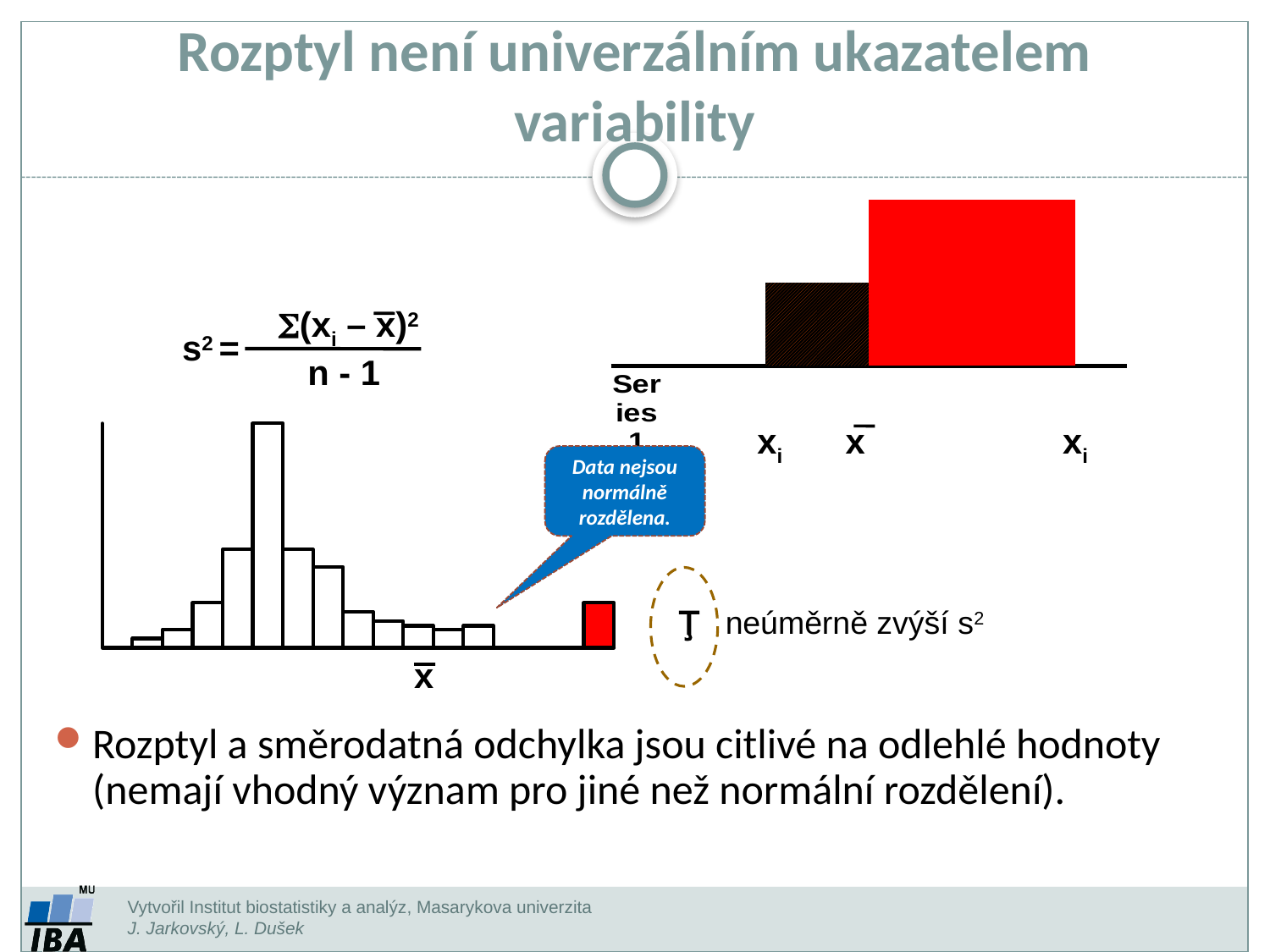
What kind of chart is shown on the right side of the slide, above the labels x_i and x̄? bar chart In the histogram on the left side of the slide, is the red outlier bar taller or shorter than the tallest white bar? shorter In the bar chart on the right side of the slide, which bar is taller, the red bar or the black hatched bar? the red bar In the histogram on the left side of the slide, what colour is the isolated outlier bar at the far right? red In the bar chart on the right side of the slide, how many bars are plotted? 2 In the bar chart on the right side of the slide, what colour is the tallest bar? red What kind of chart is the histogram-like figure on the left side of the slide? bar chart